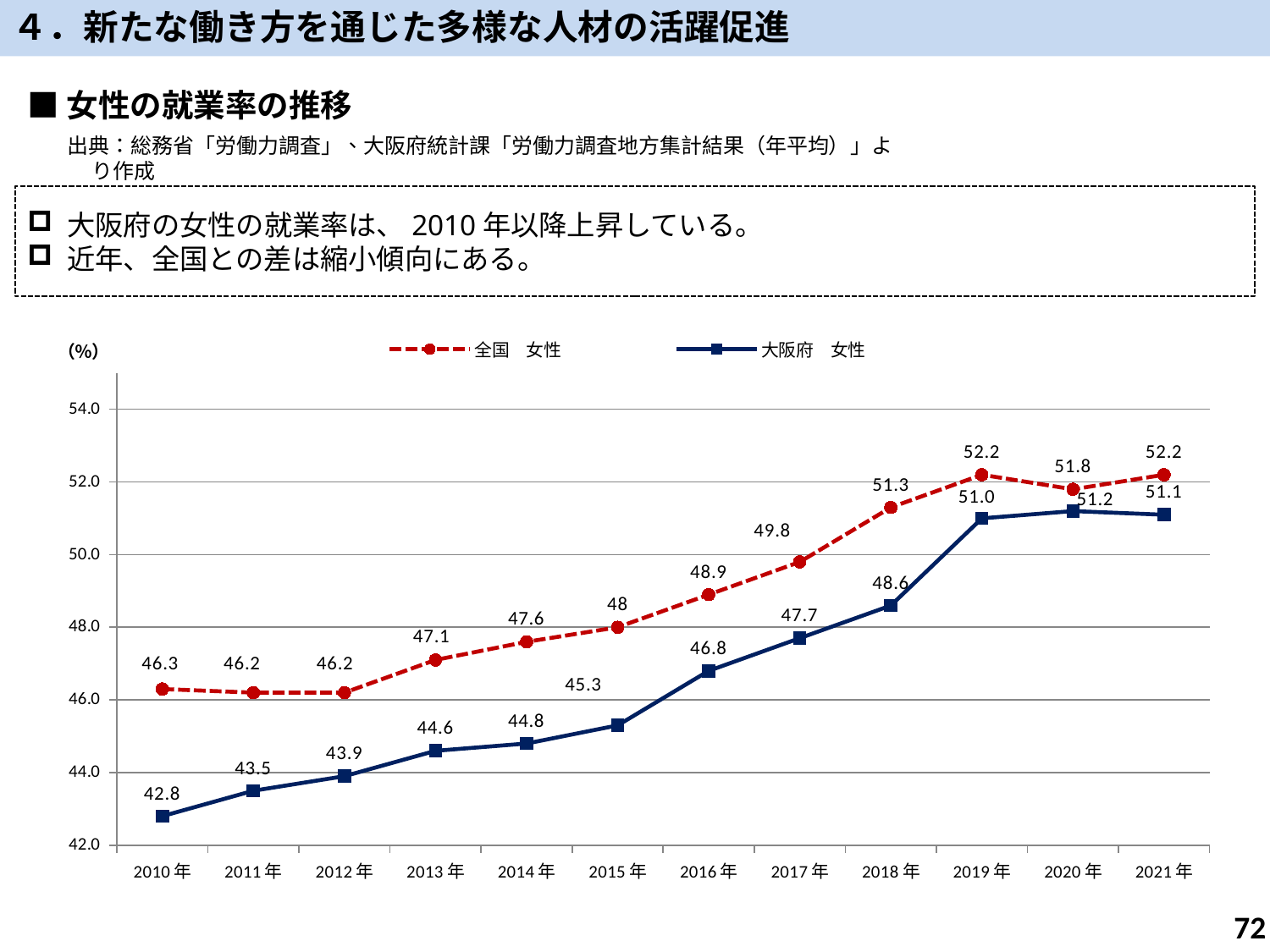
What kind of chart is shown on the slide? Line chart What is the value for 大阪府 女性 in 2010年? 42.8 What is the difference between 全国 女性 and 大阪府 女性 in 2021年? 1.1 What is the value for 全国 女性 in 2018年? 51.3 What is the difference between 全国 女性 and 大阪府 女性 in 2010年? 3.5 What is the value for 大阪府 女性 in 2019年? 51.0 Which is larger in 2016年, the value for 全国 女性 or 大阪府 女性? 全国 女性 How many series does the legend list? 2 What is the value for 全国 女性 in 2015年? 48 In which year is the value for 大阪府 女性 lowest? 2010年 How many years are plotted on the x axis? 12 In which year is the value for 大阪府 女性 highest? 2020年